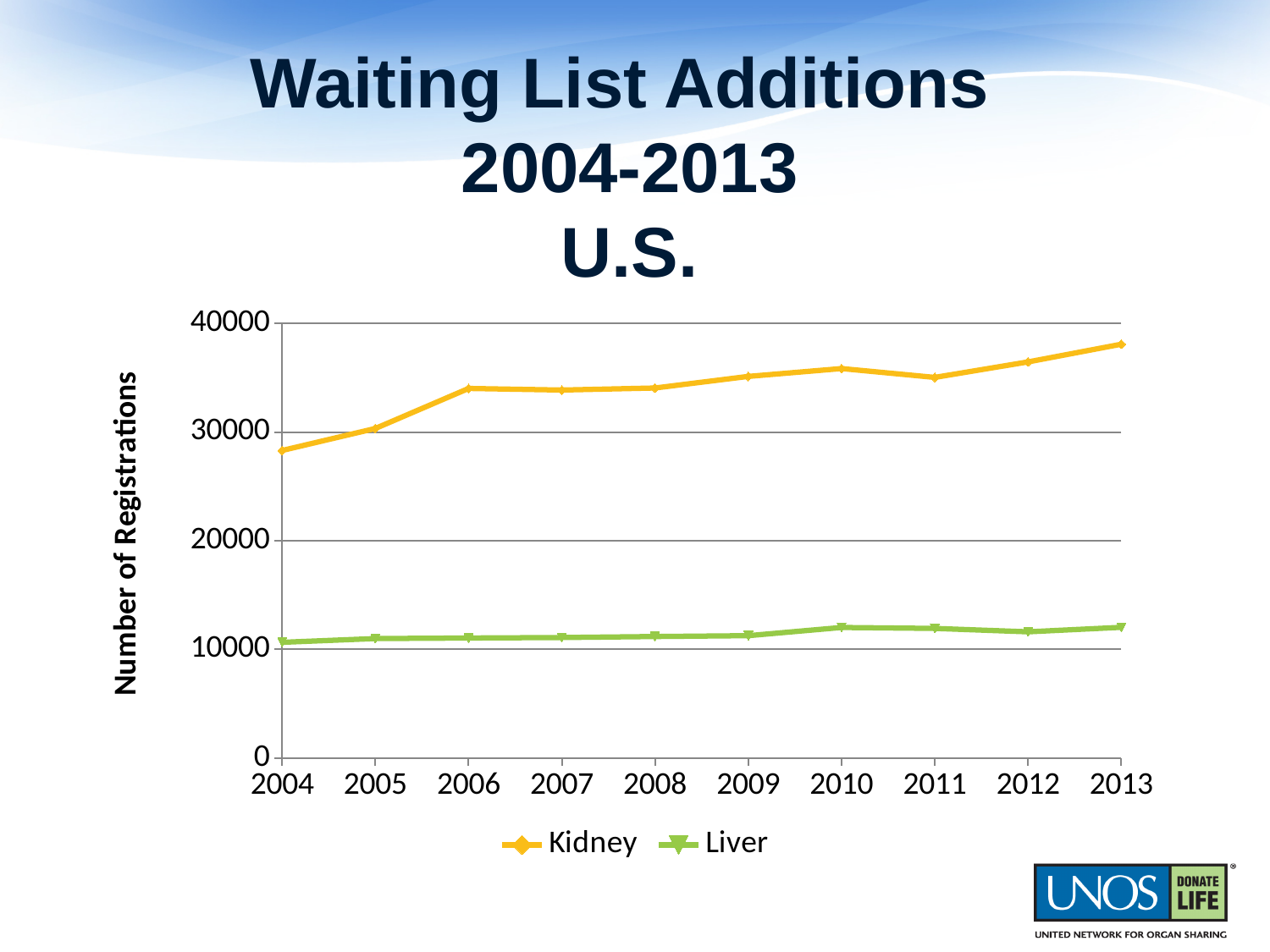
Is the Kidney value for 2004 greater or less than 30000? less Is the Liver value for 2013 greater or less than 20000? less Does the Kidney series rise or fall overall from 2004 to 2013? Rise Which series has the larger value in 2008, Kidney or Liver? Kidney In which year is the Kidney series at its lowest? 2004 In which year is the Liver series at its lowest? 2004 How many series does the legend list? 2 Is the Kidney value for 2013 greater or less than 40000? less In which year is the Kidney series at its highest? 2013 What kind of chart is shown on the slide? Line chart How many years are plotted along the x axis? 10